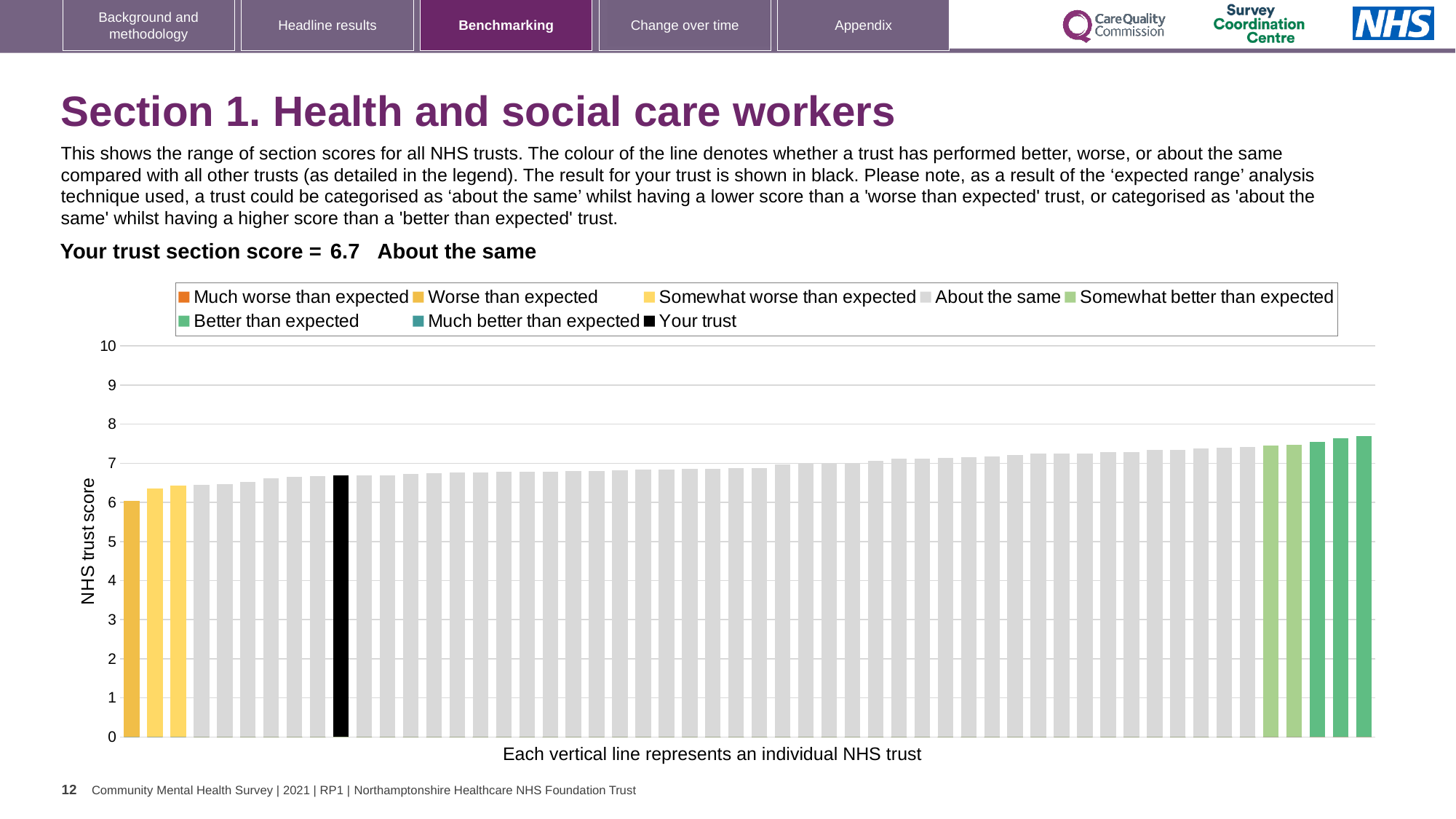
How many entries does the chart legend list? 8 How many bars are coloured as 'Somewhat worse than expected'? 2 Is the value for your trust greater or less than 7? less Is the tallest bar on the chart greater or less than 8? less What colour is the bar representing your trust? black What kind of chart is shown on the slide? bar chart Is the leftmost bar larger or smaller than the bar for your trust? smaller Is the shortest bar on the chart greater or less than 7? less Is the rightmost bar larger or smaller than the bar for your trust? larger Do the bar values rise or fall from left to right along the x axis? rise What is the section score for your trust? 6.7